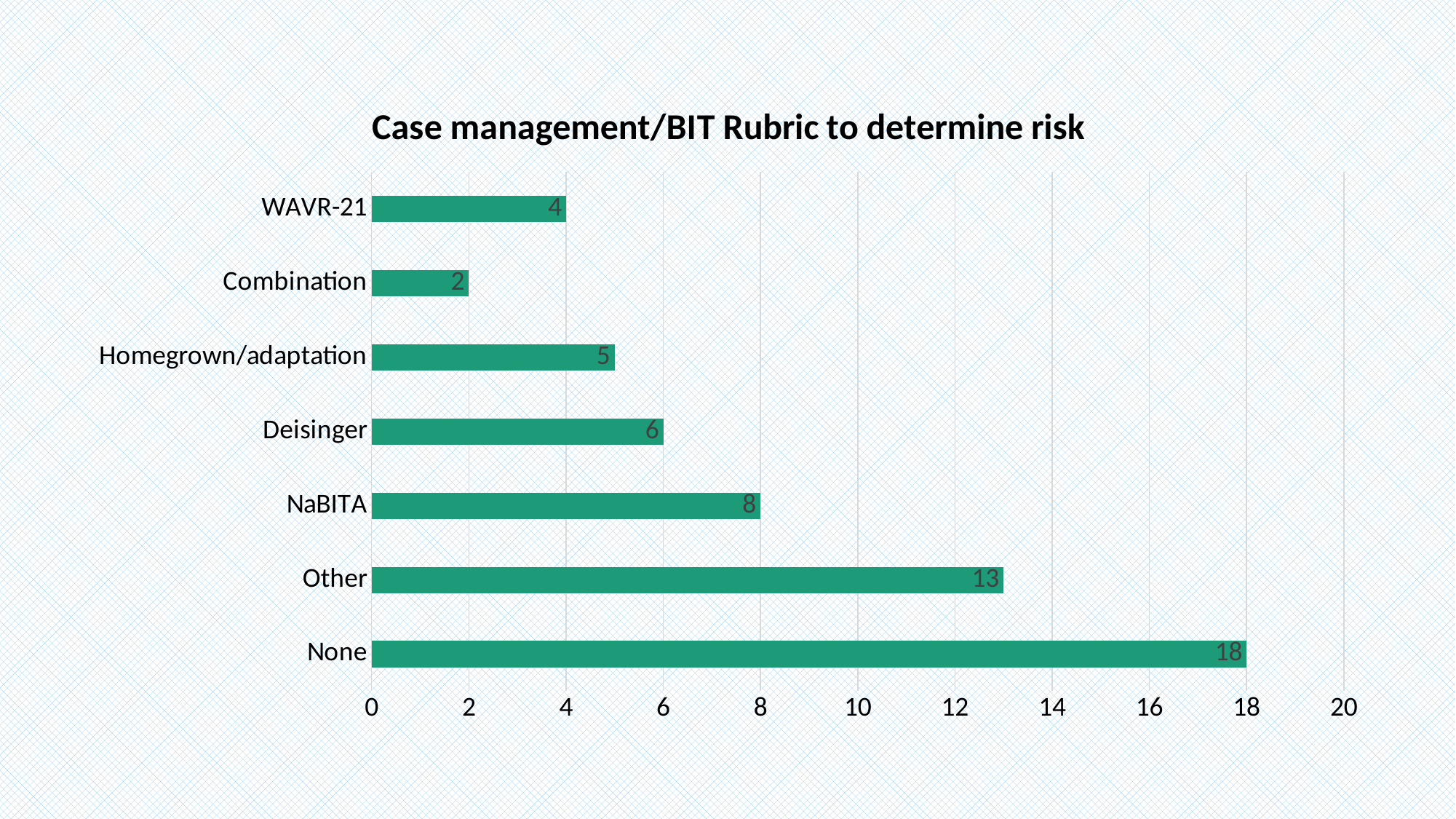
How many categories are shown in the chart? 7 Which category has the highest value? None What is the value for None? 18 What is the value for Combination? 2 What is the value for NaBITA? 8 What is the value for Homegrown/adaptation? 5 What is the title of the chart? Case management/BIT Rubric to determine risk Which category has the lowest value? Combination Is the value for Other greater or less than 10? greater What kind of chart is this? Bar chart Which is larger, the value for Deisinger or the value for WAVR-21? Deisinger What is the difference between the values for None and Other? 5